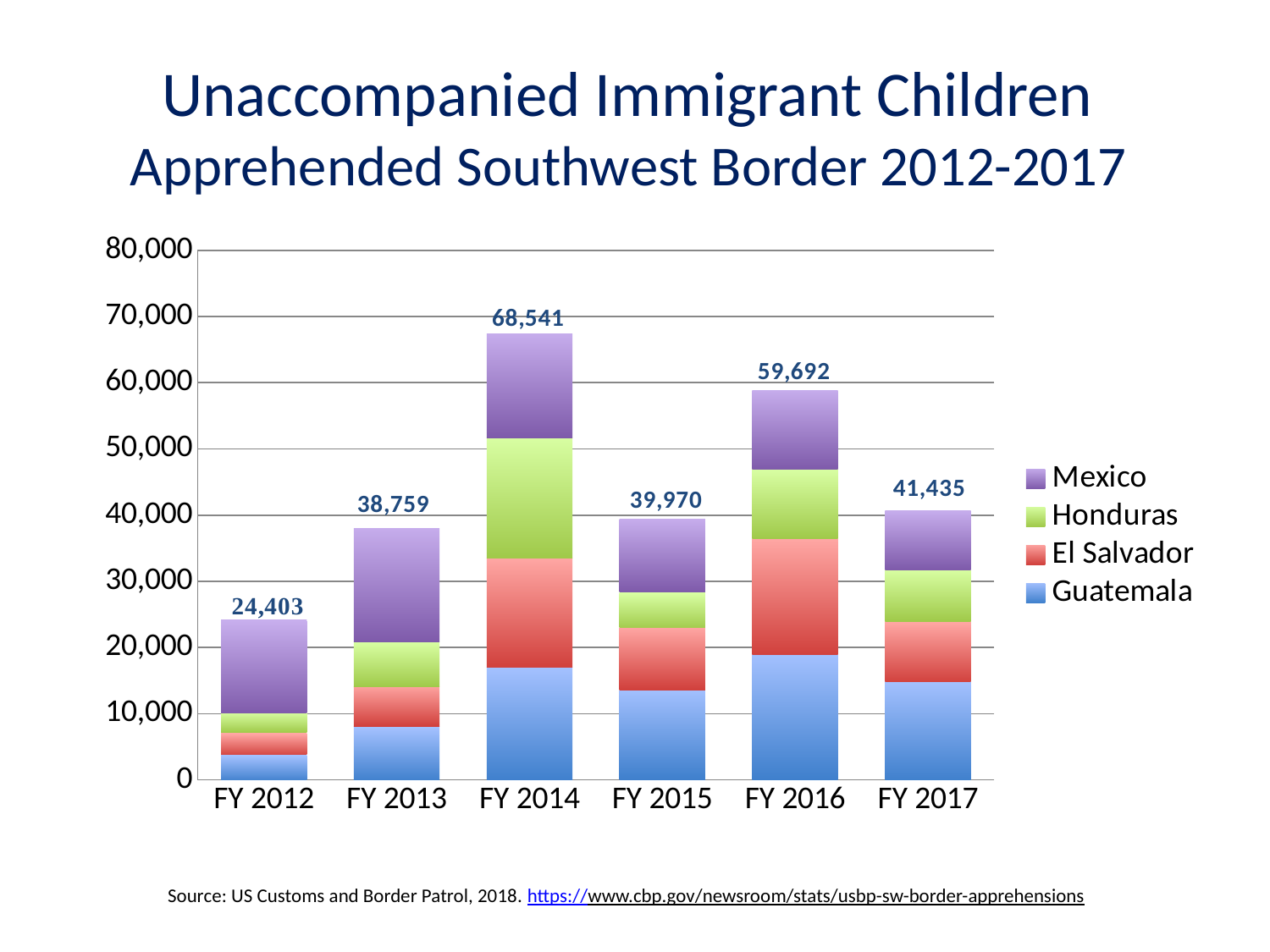
What kind of chart is shown on the slide? Stacked bar chart How many fiscal years are shown on the x axis? 6 Which total is larger, FY 2015 or FY 2017? FY 2017 What is the total number of unaccompanied immigrant children apprehended in FY 2014? 68,541 Is the Guatemala segment for FY 2012 greater or less than 10,000? less What is the total labeled above the FY 2012 bar? 24,403 Which fiscal year has the lowest total of apprehensions? FY 2012 Which country is shown in purple in the legend? Mexico What is the difference between the FY 2014 total and the FY 2016 total? 8,849 How many countries are listed in the legend? 4 Which fiscal year has the highest total of apprehensions? FY 2014 Is the Guatemala segment for FY 2016 greater or less than 10,000? greater